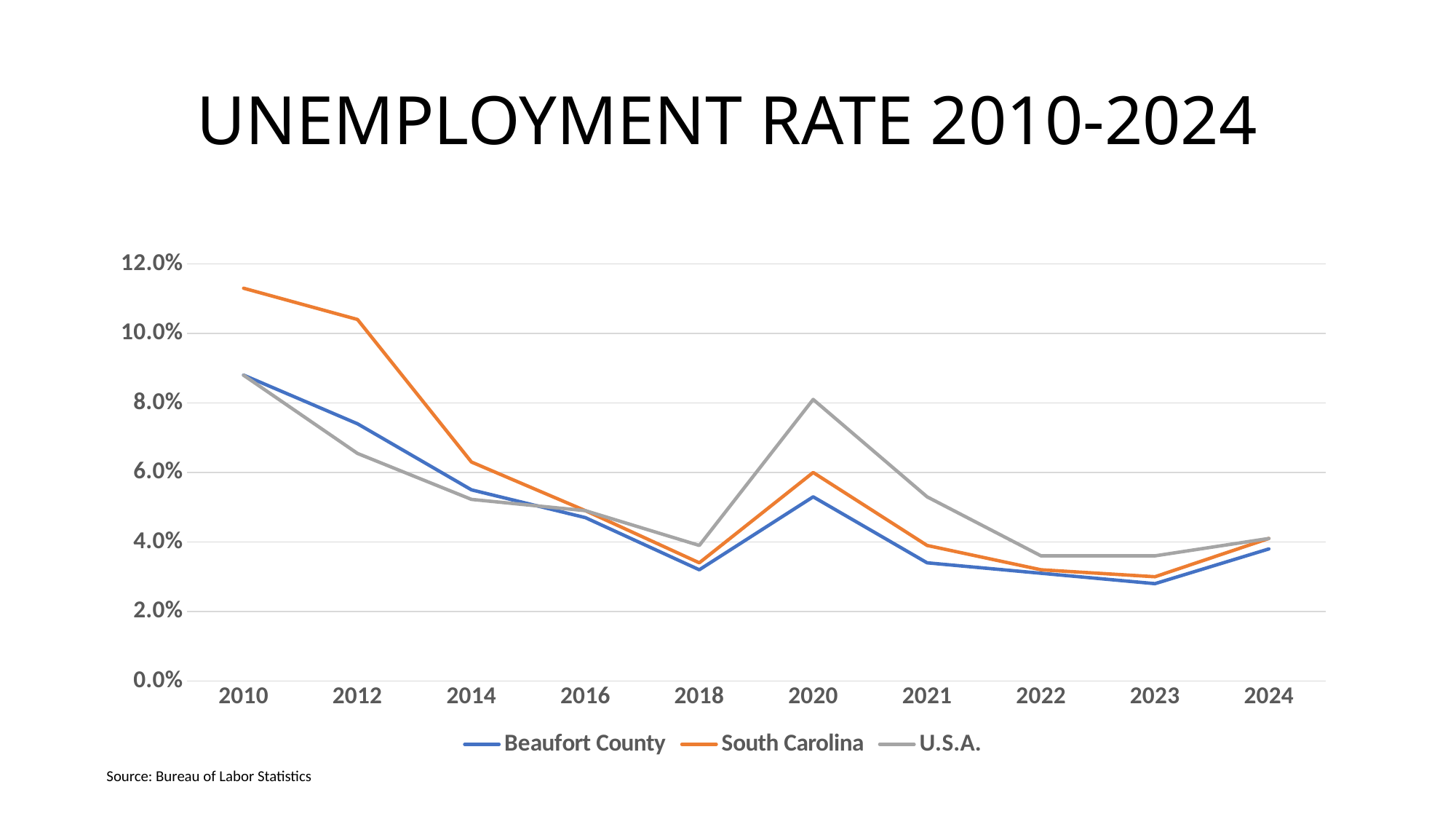
Which series has the highest unemployment rate in 2010? South Carolina How many series does the legend list? 3 Which is larger in 2020, the U.S.A. rate or the South Carolina rate? U.S.A. Does the Beaufort County unemployment rate rise or fall from 2010 to 2018? fall In which year is the South Carolina unemployment rate highest? 2010 Which series has the highest unemployment rate in 2020? U.S.A. Is the U.S.A. unemployment rate in 2020 greater or less than 6.0%? greater What kind of chart is shown on the slide? line chart Is the Beaufort County unemployment rate in 2018 greater or less than 4.0%? less In which year is the Beaufort County unemployment rate lowest? 2023 How many years are shown on the x axis? 10 Is the South Carolina unemployment rate in 2010 greater or less than 10.0%? greater